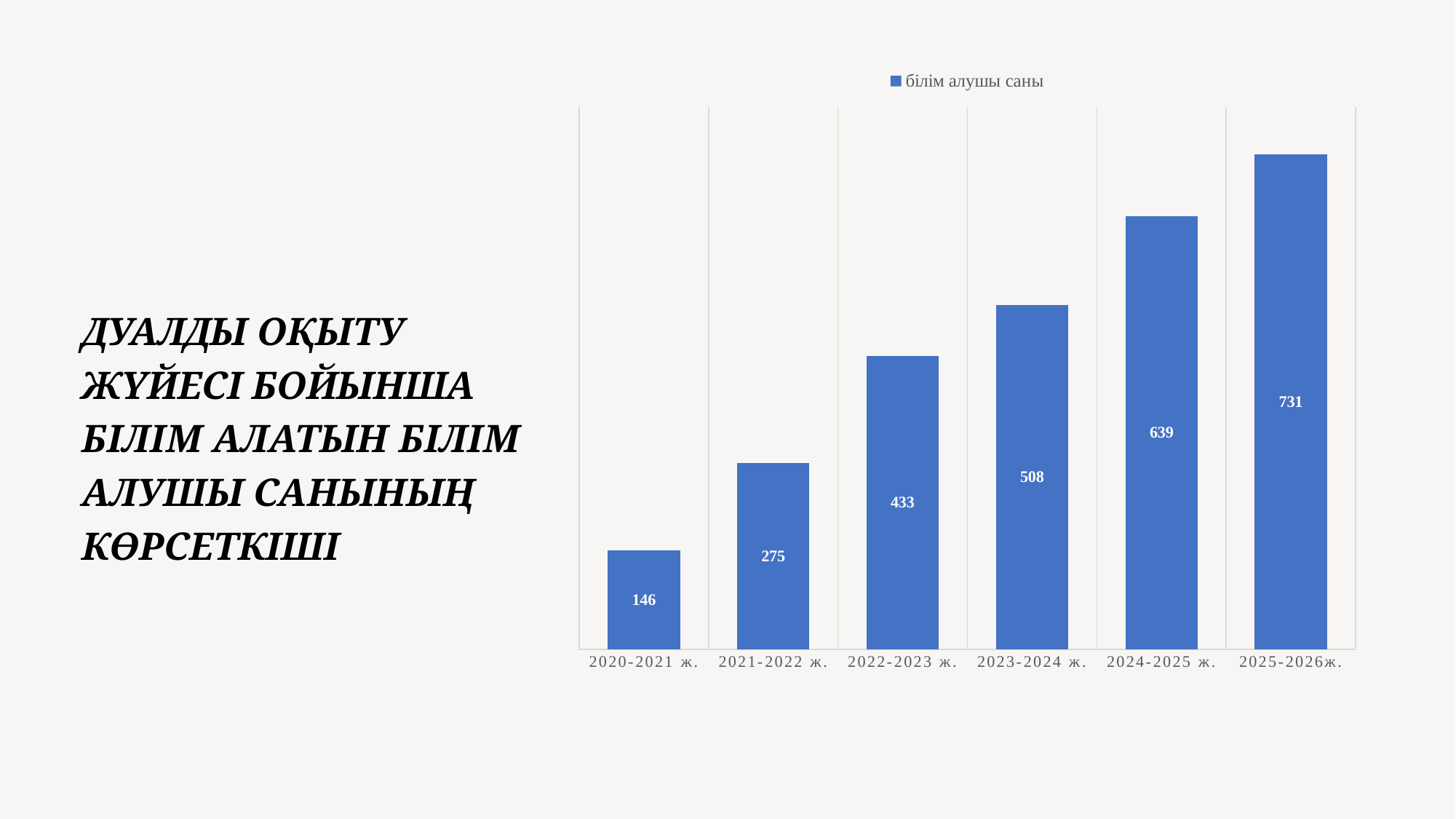
What is the difference between the values for 2025-2026ж. and 2024-2025 ж.? 92 What is the value for 2024-2025 ж.? 639 Which category has the lowest value? 2020-2021 ж. Which category has the highest value? 2025-2026ж. Which is larger, the value for 2023-2024 ж. or the value for 2022-2023 ж.? 2023-2024 ж. What is the difference between the values for 2021-2022 ж. and 2020-2021 ж.? 129 What kind of chart is shown on the slide? bar chart Do the values rise or fall from 2020-2021 ж. to 2025-2026ж.? rise How many categories are shown on the x axis? 6 How many series does the legend list? 1 What is the value for 2020-2021 ж.? 146 What is the value for 2022-2023 ж.? 433